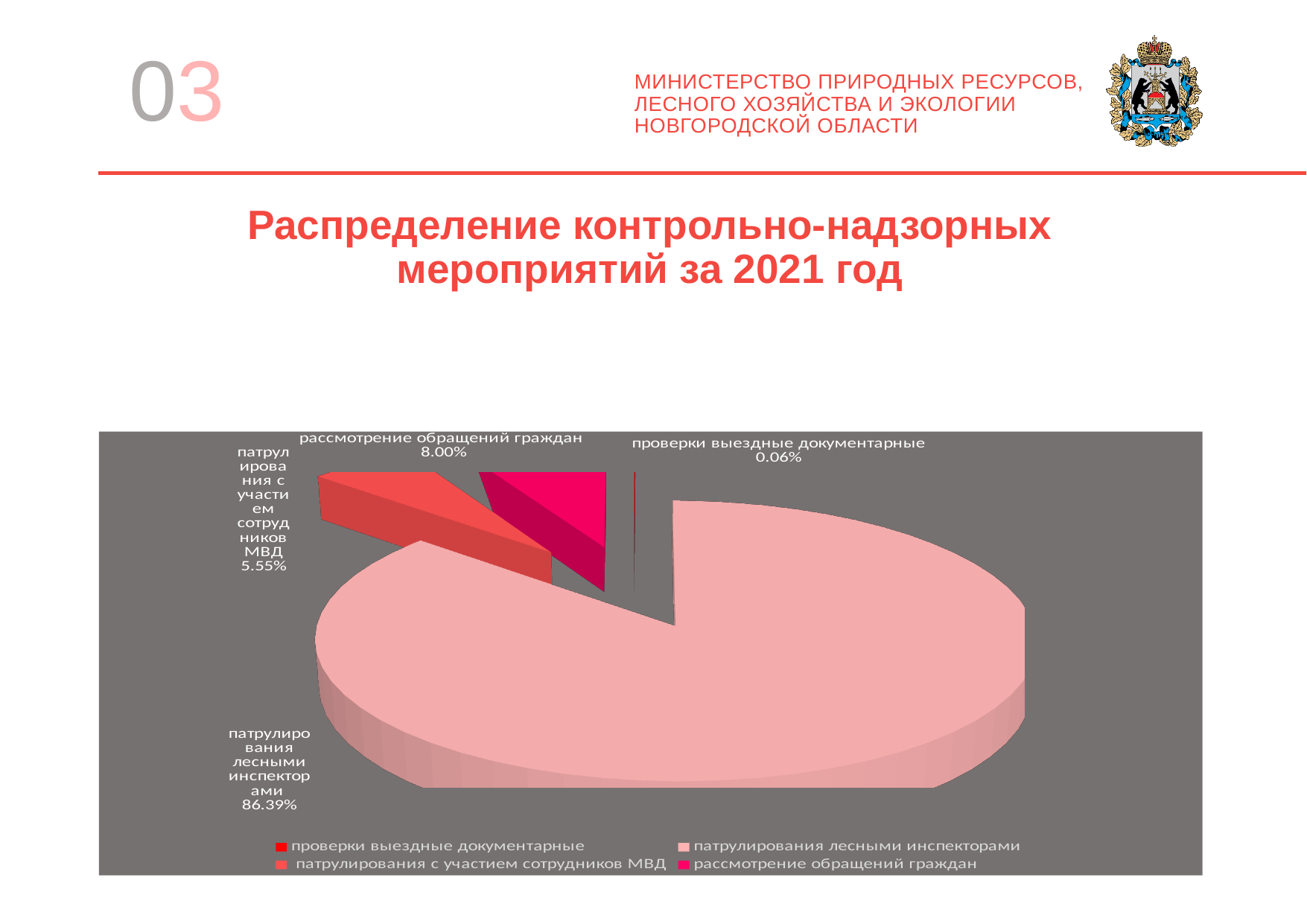
What share of the pie is labelled for патрулирования лесными инспекторами? 86.39% What share of the pie is labelled for рассмотрение обращений граждан? 8.00% How many slices does the pie chart have? 4 What share of the pie is labelled for проверки выездные документарные? 0.06% What is the difference in percentage points between рассмотрение обращений граждан and патрулирования с участием сотрудников МВД? 2.45 What is the title of the slide above the chart? Распределение контрольно-надзорных мероприятий за 2021 год What kind of chart is shown on the slide? pie chart Which is larger: the share for рассмотрение обращений граждан or the share for патрулирования с участием сотрудников МВД? рассмотрение обращений граждан Which category has the smallest slice of the pie? проверки выездные документарные Which category has the largest slice of the pie? патрулирования лесными инспекторами How many entries does the legend list? 4